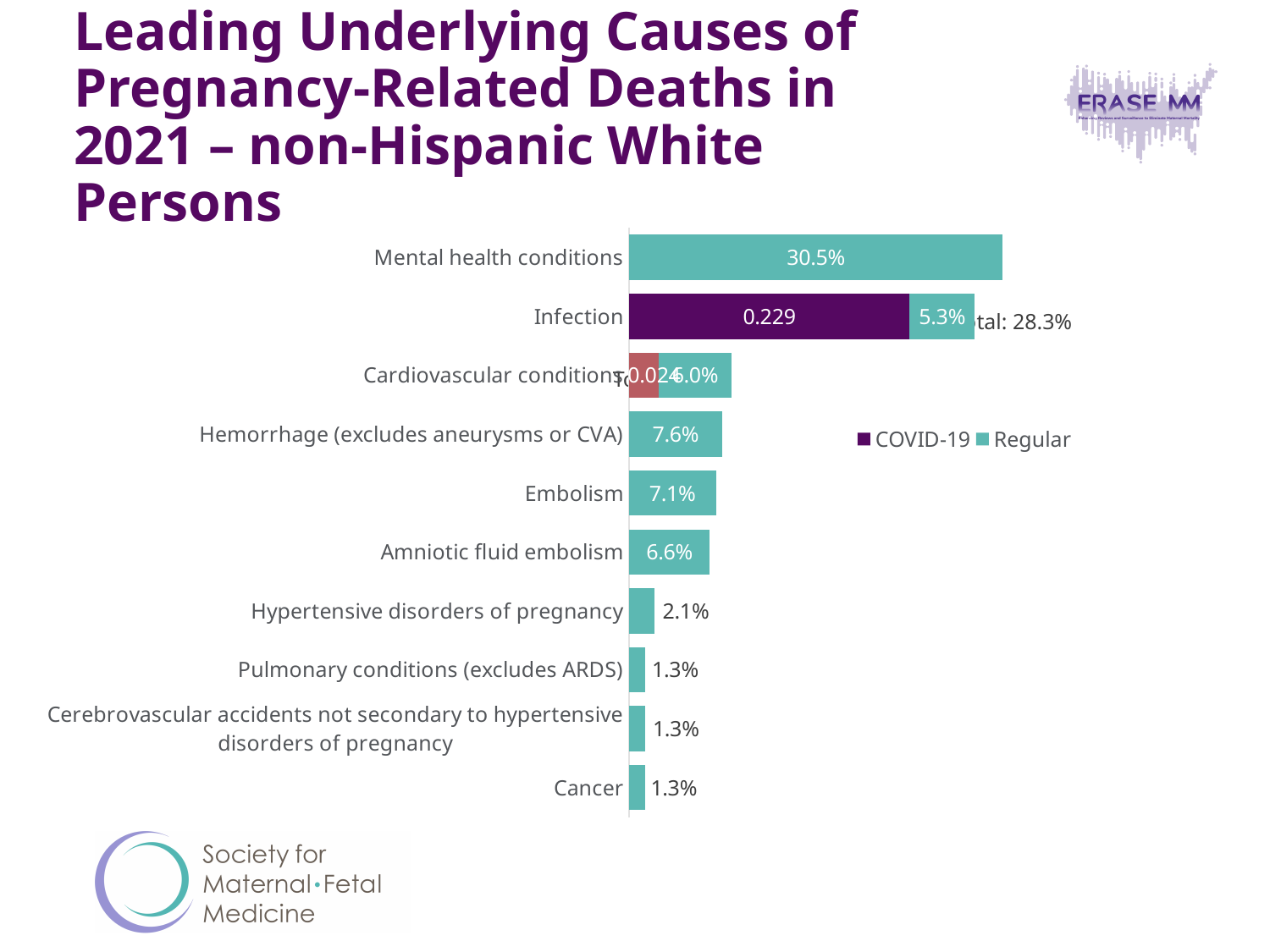
How many series does the legend list? 2 What is the Regular value for Hemorrhage (excludes aneurysms or CVA)? 7.6% What kind of chart is shown on the slide? Bar chart What is the value for Embolism? 7.1% What is the difference between the values for Embolism and Amniotic fluid embolism? 0.5% What is the value for Mental health conditions? 30.5% How many categories are shown on the chart? 10 What is the value for Hypertensive disorders of pregnancy? 2.1% What is the COVID-19 value shown for Infection? 0.229 What is the Regular value shown for Infection? 5.3% Which category has the highest value? Mental health conditions What is the value for Amniotic fluid embolism? 6.6%